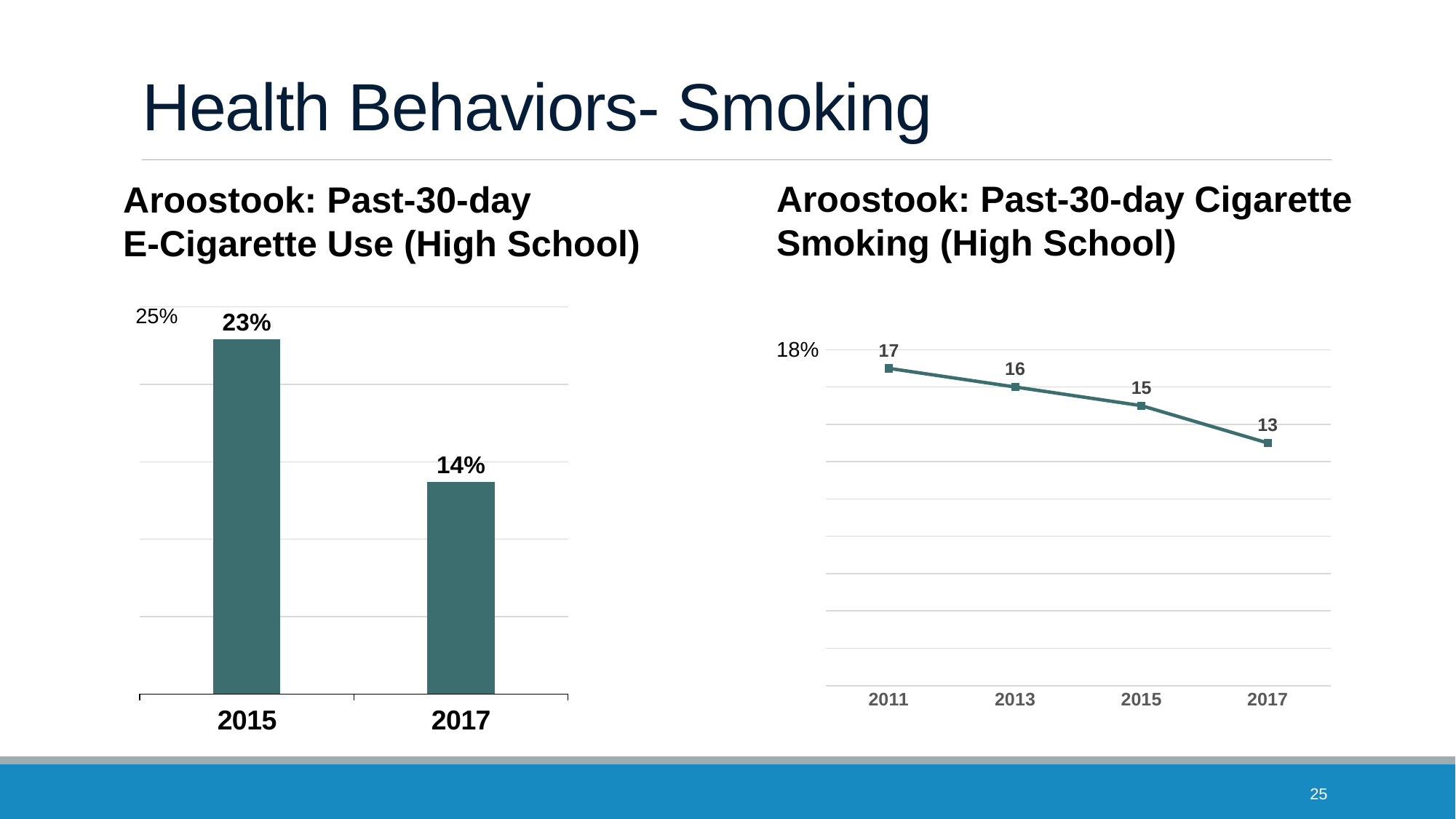
In the 'Aroostook: Past-30-day Cigarette Smoking (High School)' chart, which year has the lowest value? 2017 In the 'Aroostook: Past-30-day E-Cigarette Use (High School)' chart, what is the value for 2017? 14% In the 'Aroostook: Past-30-day Cigarette Smoking (High School)' chart, what is the value for 2017? 13 In the 'Aroostook: Past-30-day E-Cigarette Use (High School)' chart, what is the value for 2015? 23% In the 'Aroostook: Past-30-day Cigarette Smoking (High School)' chart, do the values rise or fall from 2011 to 2017? Fall What kind of chart is the 'Aroostook: Past-30-day Cigarette Smoking (High School)' chart? Line chart What kind of chart is the 'Aroostook: Past-30-day E-Cigarette Use (High School)' chart? Bar chart In the 'Aroostook: Past-30-day Cigarette Smoking (High School)' chart, what is the value for 2011? 17 In the 'Aroostook: Past-30-day Cigarette Smoking (High School)' chart, what is the difference between the 2011 and 2017 values? 4 In the 'Aroostook: Past-30-day E-Cigarette Use (High School)' chart, what is the difference between the 2015 and 2017 values? 9% How many bars are in the 'Aroostook: Past-30-day E-Cigarette Use (High School)' chart? 2 In the 'Aroostook: Past-30-day E-Cigarette Use (High School)' chart, which year has the higher value? 2015